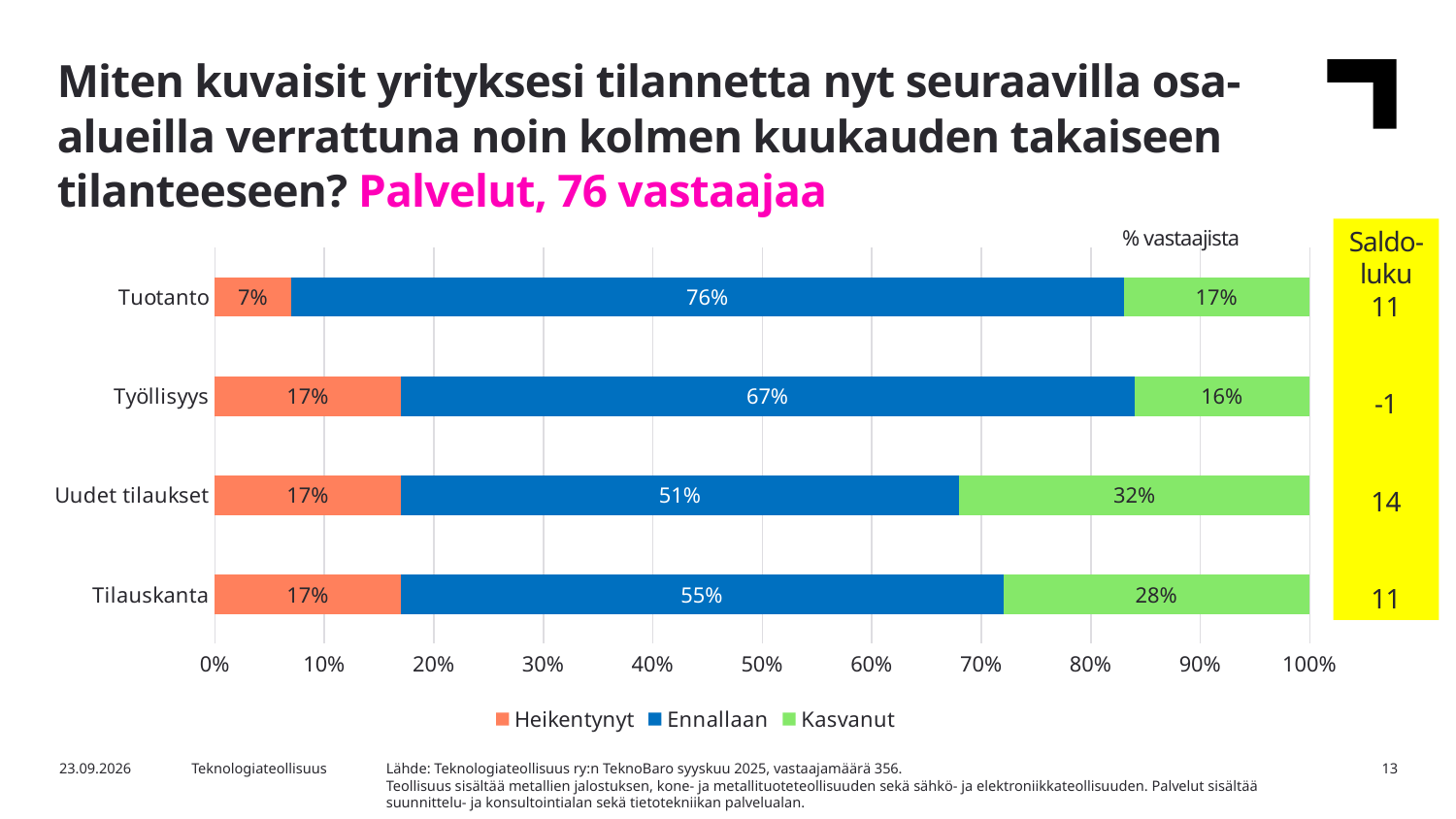
Which series is shown in green in the legend? Kasvanut What is the Saldoluku value shown for Työllisyys? -1 How many categories are shown on the chart? 4 What percentage of respondents answered "Ennallaan" for Tuotanto? 76% How many series does the legend list? 3 What kind of chart is shown on the slide? Stacked bar chart What is the "Heikentynyt" value for Tilauskanta? 17% Which category has the highest "Kasvanut" share? Uudet tilaukset Which category has the lowest "Heikentynyt" share? Tuotanto Is the "Kasvanut" value larger for Tilauskanta or for Työllisyys? Tilauskanta What is the difference between the "Ennallaan" values for Tuotanto and Tilauskanta? 21 percentage points What is the "Kasvanut" value for Uudet tilaukset? 32%